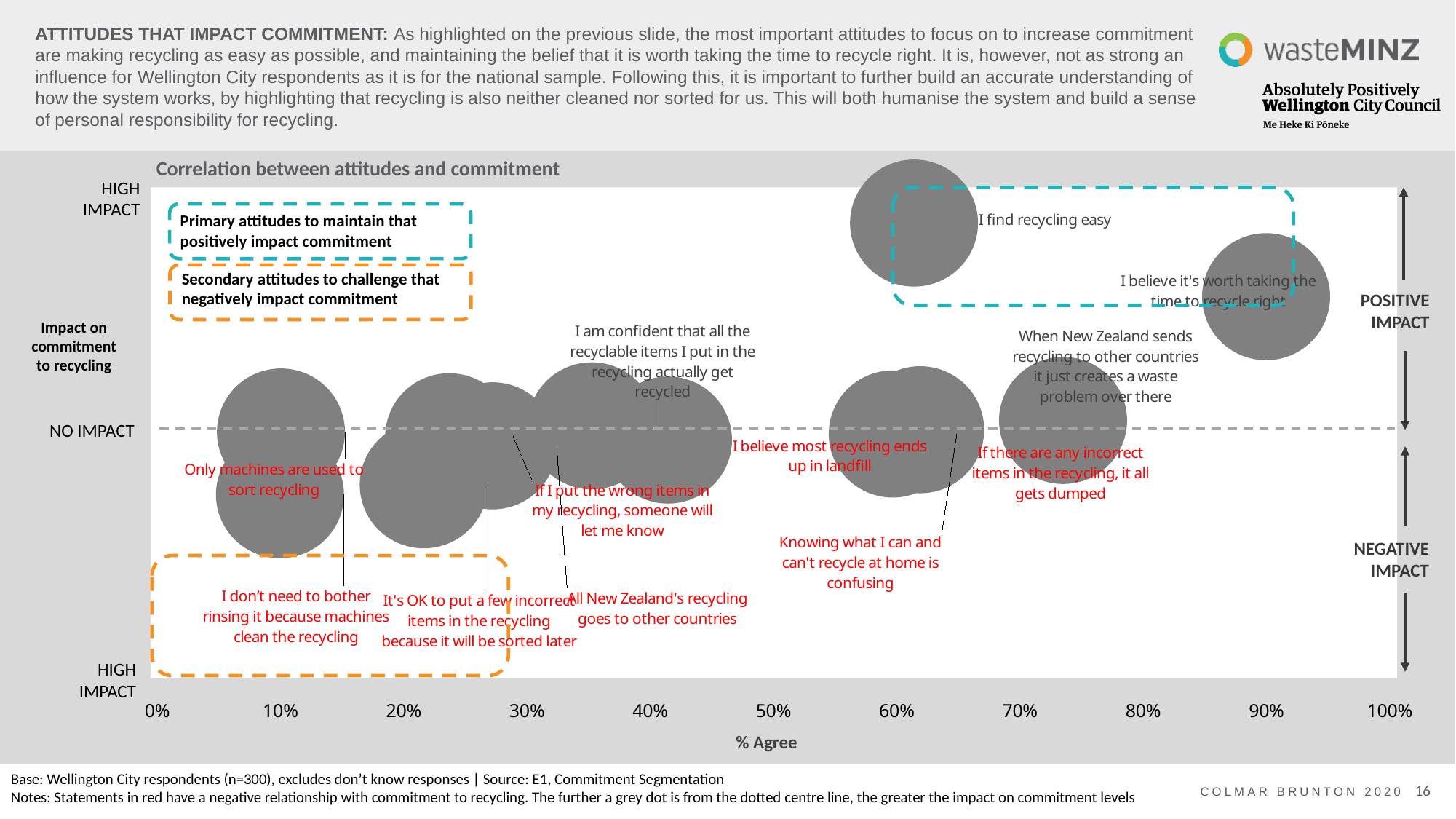
How many statements on the chart are written in red (negative relationship with commitment)? 8 What kind of chart is shown on the slide? bubble chart Which statement has the highest % Agree on the chart? I believe it's worth taking the time to recycle right Is the % Agree for "If there are any incorrect items in the recycling, it all gets dumped" greater or less than 60%? greater What is the title of the chart? Correlation between attitudes and commitment What is the label of the horizontal axis of the chart? % Agree Is the % Agree for "I believe most recycling ends up in landfill" greater or less than 50%? greater Which statement has a higher % Agree: "I find recycling easy" or "I believe it's worth taking the time to recycle right"? I believe it's worth taking the time to recycle right Is the % Agree for "I find recycling easy" greater or less than 50%? greater